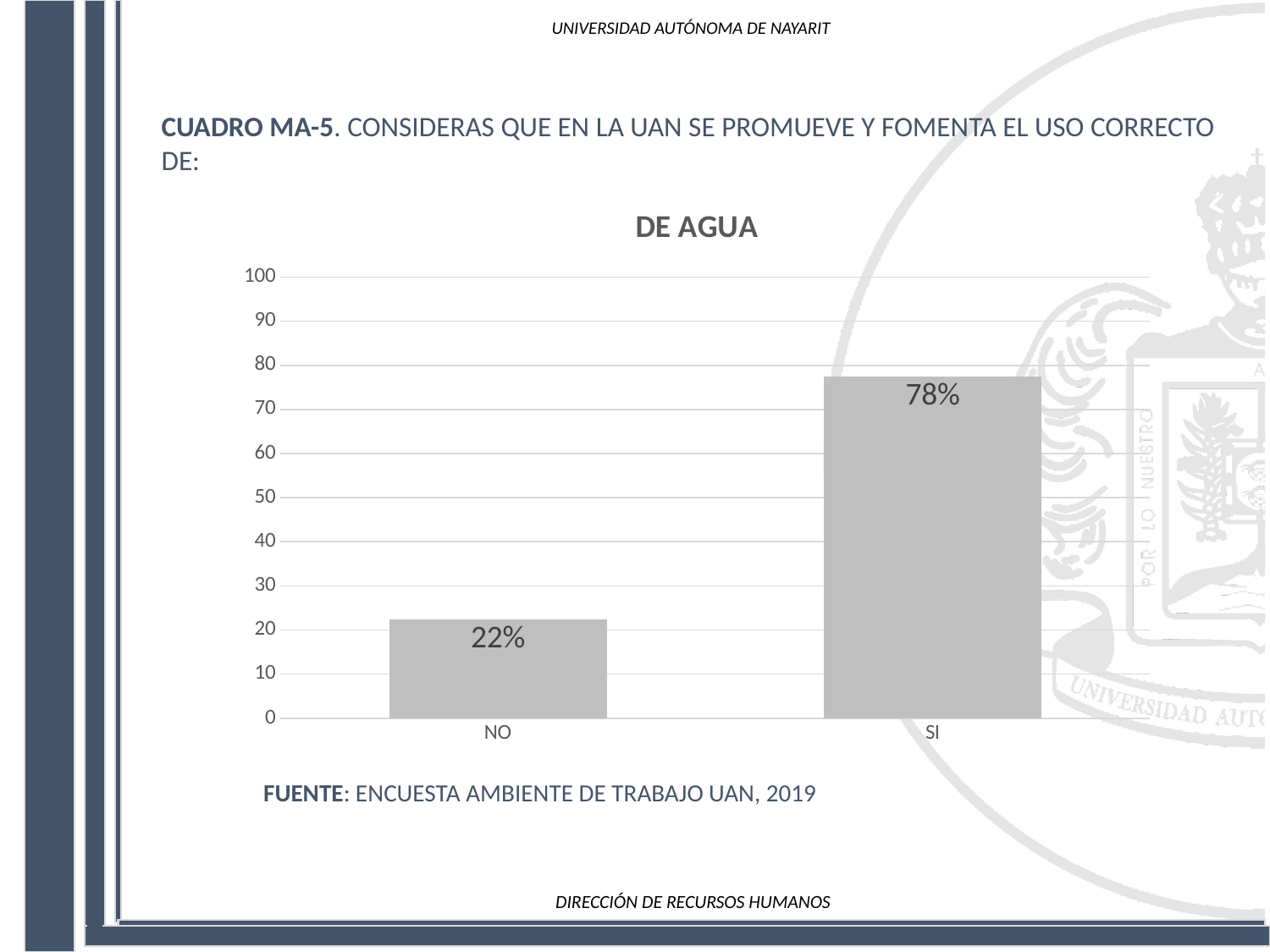
What is the highest value shown on the y axis? 100 Is the value for NO greater or less than 30? less What is the title of the chart? DE AGUA What is the difference between the values for SI and NO? 56% Which is larger, the value for NO or the value for SI? SI Which category has the highest value? SI Which category has the lowest value? NO What is the value for SI? 78% Is the value for SI greater or less than 70? greater How many categories are shown on the x axis? 2 What is the value for NO? 22% What kind of chart is shown? bar chart